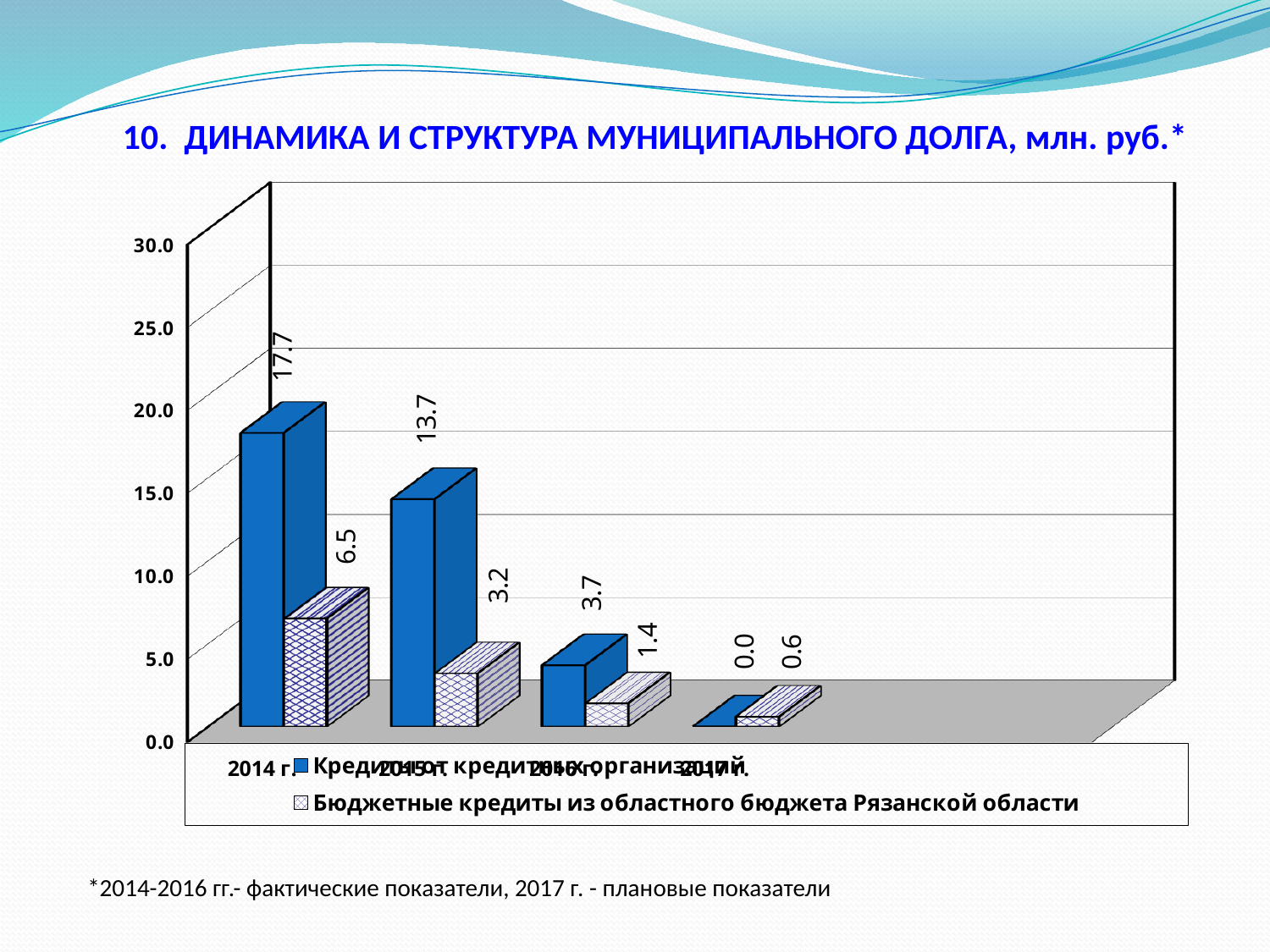
What is the value for Кредиты от кредитных организаций in 2014 г.? 17.7 Which is larger in 2016 г.: Кредиты от кредитных организаций or Бюджетные кредиты из областного бюджета Рязанской области? Кредиты от кредитных организаций What is the difference between Кредиты от кредитных организаций and Бюджетные кредиты in 2014 г.? 11.2 How many series does the legend list? 2 In which year is the value for Бюджетные кредиты из областного бюджета Рязанской области lowest? 2017 г. What is the title of the chart? 10. ДИНАМИКА И СТРУКТУРА МУНИЦИПАЛЬНОГО ДОЛГА, млн. руб.* Do the values for Кредиты от кредитных организаций rise or fall from 2014 г. to 2017 г.? fall How many year categories are shown on the x axis? 4 In which year is the value for Кредиты от кредитных организаций highest? 2014 г. What is the value for Бюджетные кредиты из областного бюджета Рязанской области in 2015 г.? 3.2 What type of chart is shown on the slide? bar chart What is the value for Кредиты от кредитных организаций in 2017 г.? 0.0